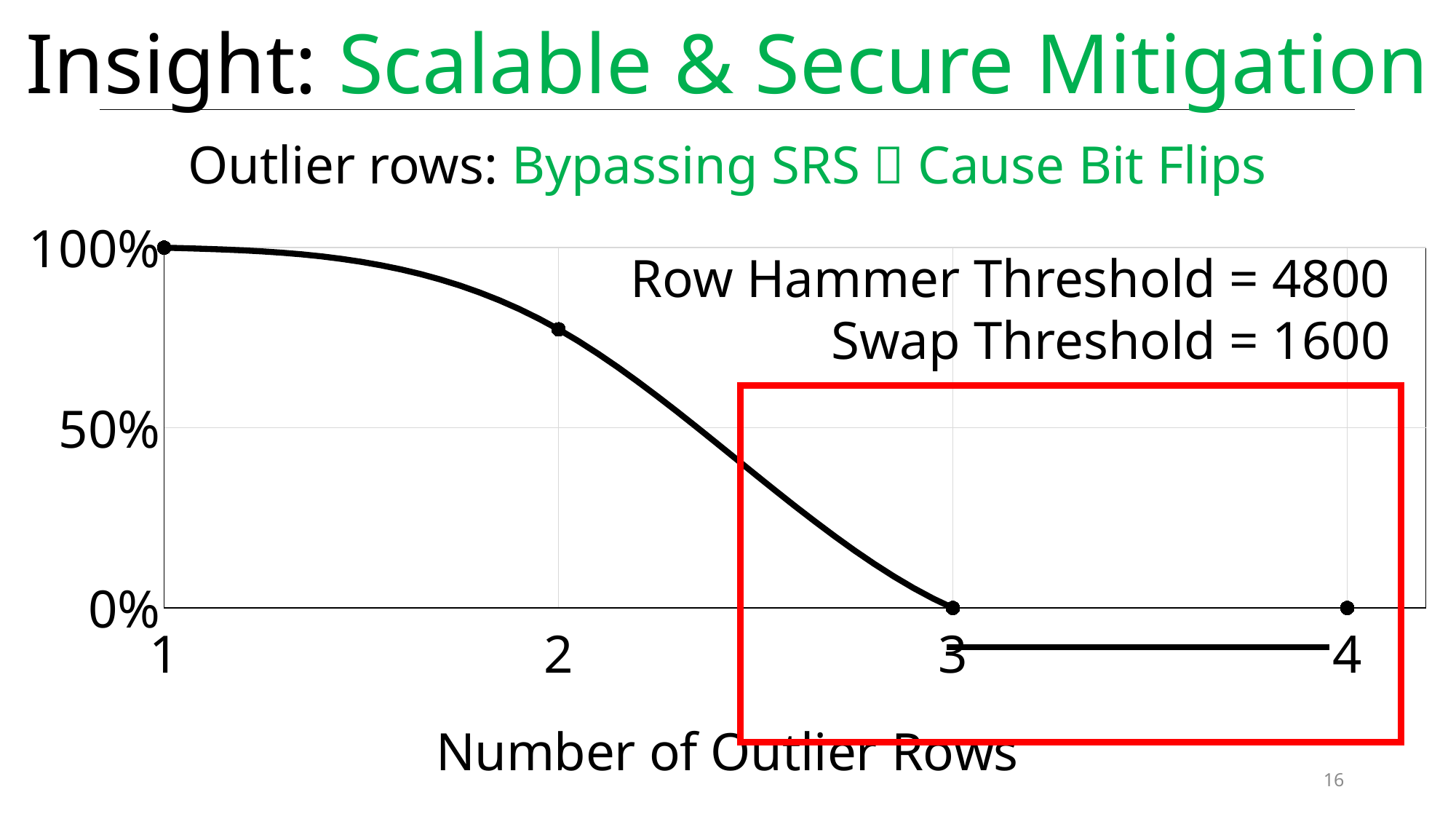
What Row Hammer Threshold is stated in the chart annotation? 4800 What kind of chart is shown on the slide? line chart How many data points are plotted on the line? 4 What value does the line show at 3 outlier rows? 0% What is the title of the x axis? Number of Outlier Rows Do the values rise or fall as the number of outlier rows increases from 1 to 3? fall At which number of outlier rows is the plotted value highest? 1 What value does the line show at 4 outlier rows? 0% Which has the larger value: 2 outlier rows or 3 outlier rows? 2 outlier rows What value does the line show at 1 outlier row? 100% Is the value at 2 outlier rows greater or less than 50%? greater